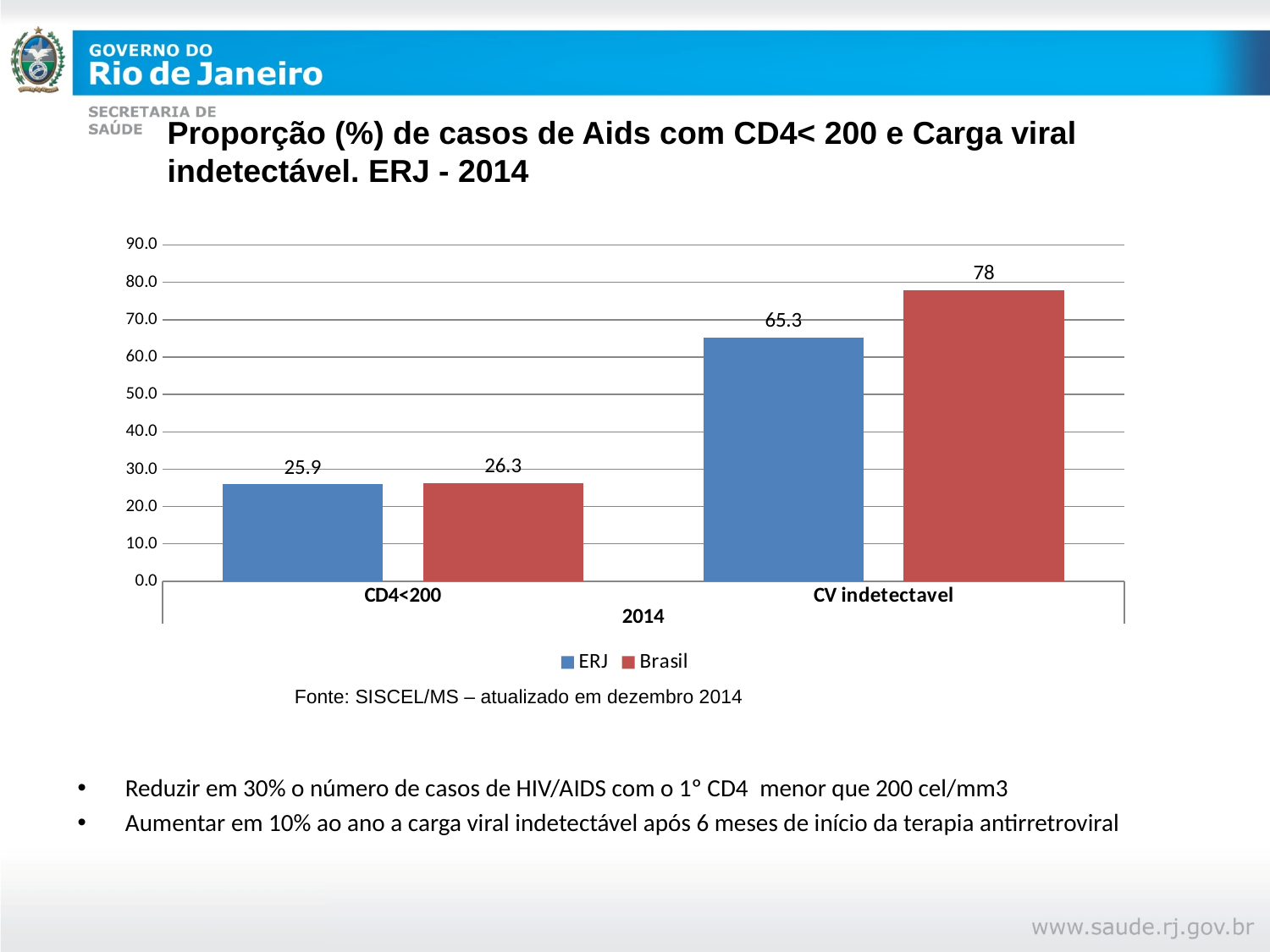
What is the value for Brasil in the CV indetectavel category? 78 Is the value for ERJ in the CV indetectavel category greater or less than 60.0? greater What kind of chart is shown on the slide? Bar chart How many categories are shown on the x axis? 2 What is the value for ERJ in the CD4<200 category? 25.9 Which bar has the lowest value on the chart? ERJ, CD4<200 Which bar has the highest value on the chart? Brasil, CV indetectavel How many series does the legend list? 2 Which is larger in the CV indetectavel category, ERJ or Brasil? Brasil What is the value for ERJ in the CV indetectavel category? 65.3 What is the value for Brasil in the CD4<200 category? 26.3 What is the difference between the Brasil and ERJ values in the CV indetectavel category? 12.7